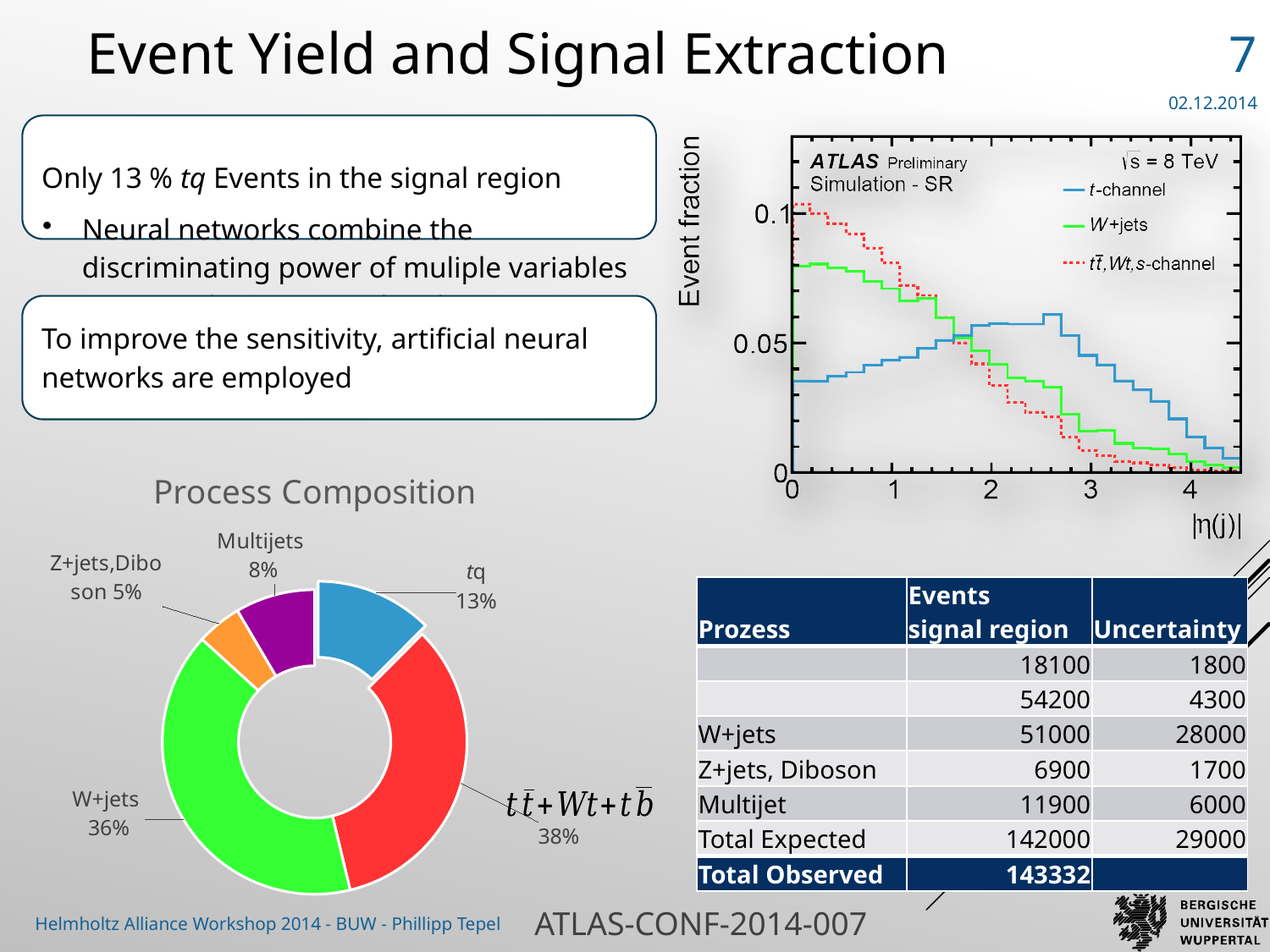
In the Process Composition chart, which process has the smallest share? Z+jets,Diboson (5%) In the Process Composition chart, how many slices does the pie have? 5 In the Process Composition chart, what is the difference between the W+jets share and the Multijets share? 28% In the Process Composition chart, what share of events is W+jets? 36% What kind of chart is the Process Composition chart? Pie (doughnut) chart In the ATLAS Event fraction plot, does the W+jets event fraction rise or fall as |η(j)| increases? fall In the ATLAS Event fraction plot, how many series does the legend list? 3 In the Process Composition chart, what share of events is Multijets? 8% In the Process Composition chart, which is larger, the tq share or the Multijets share? tq In the Process Composition chart, what share of events is tq? 13% In the ATLAS Event fraction plot, is the t-channel event fraction at |η(j)| = 0 greater or less than 0.05? less